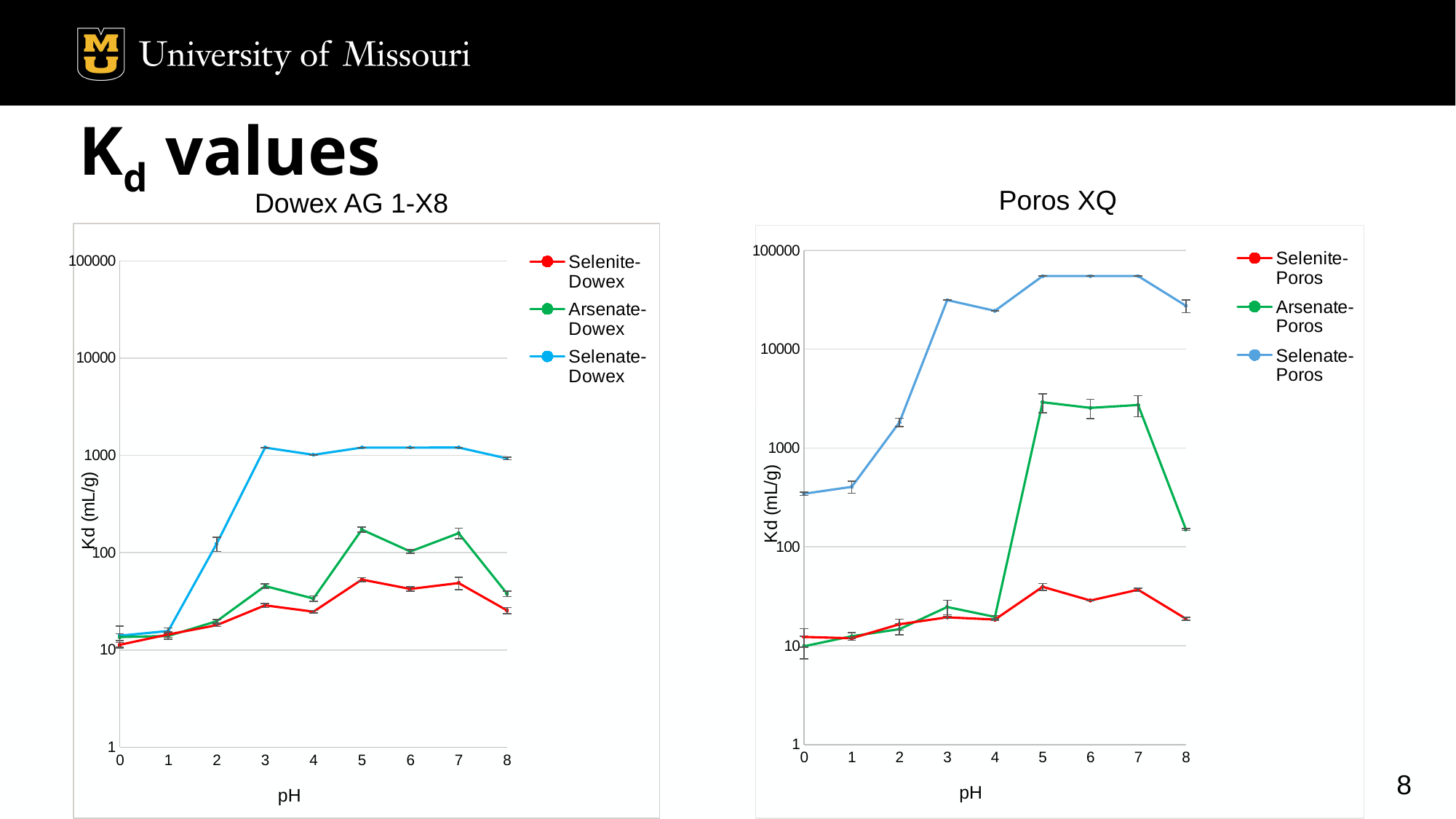
In the Dowex AG 1-X8 chart, is the Selenite-Dowex value at pH 5 greater or less than 100? less In the Dowex AG 1-X8 chart, which series has the larger value at pH 5, Selenate-Dowex or Arsenate-Dowex? Selenate-Dowex How many series does the legend of the Poros XQ chart list? 3 In the Poros XQ chart, is the Selenate-Poros value at pH 5 greater or less than 10000? greater In the Poros XQ chart, is the Arsenate-Poros value at pH 6 greater or less than 1000? greater In the Poros XQ chart, does the Selenate-Poros series rise or fall from pH 0 to pH 5? rise What is the label on the y axis of the Poros XQ chart? Kd (mL/g) How many pH points are plotted for each series in the Dowex AG 1-X8 chart? 9 What kind of chart is the Dowex AG 1-X8 chart? line chart